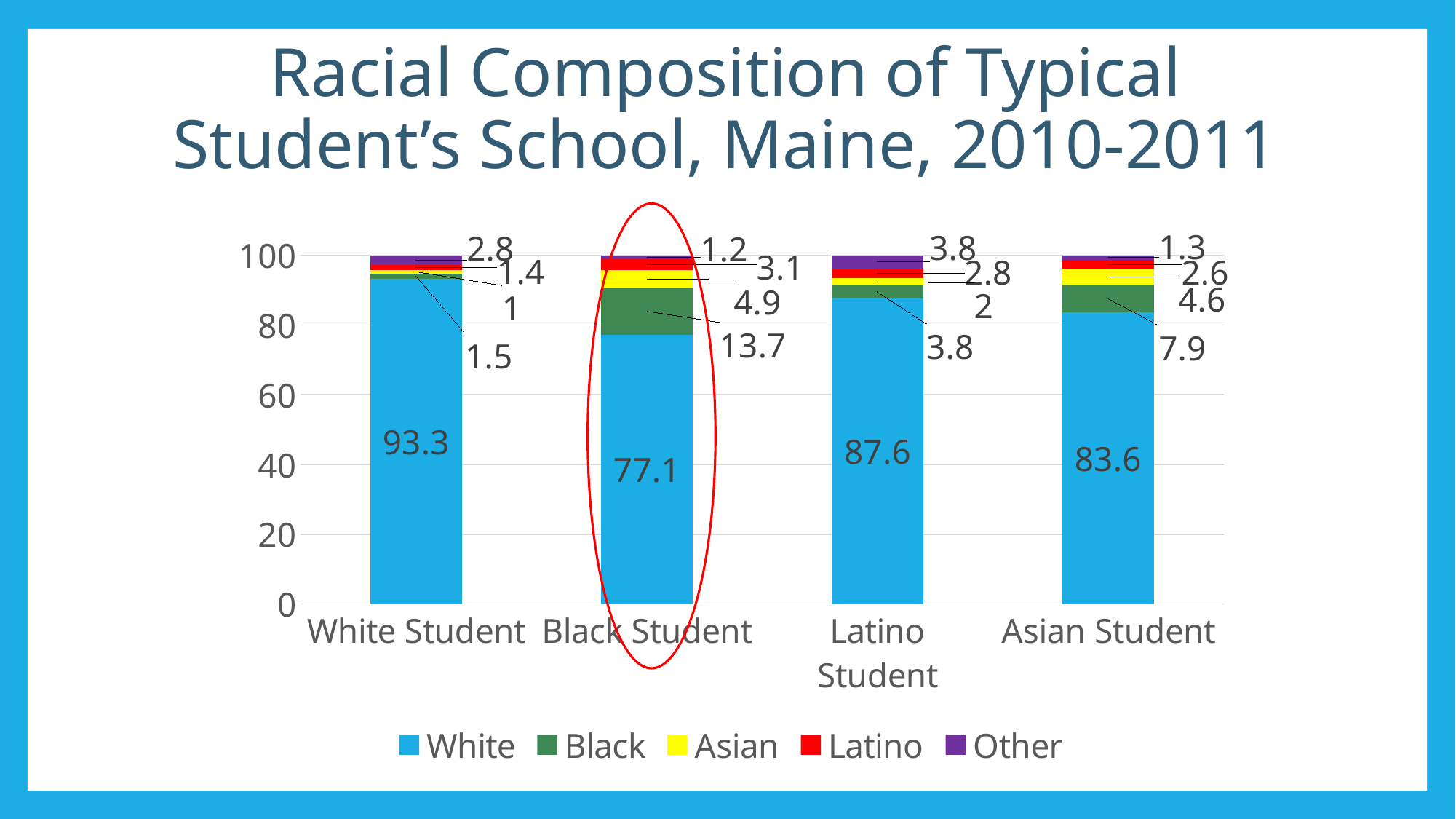
What is the difference between the White value for White Student and the White value for Black Student? 16.2 Which student category has the highest White value? White Student How many series does the legend list? 5 Which has a larger White value, Latino Student or Asian Student? Latino Student What is the White value for the Latino Student bar? 87.6 What is the Black value for the Asian Student bar? 7.9 Which student category has the lowest White value? Black Student What is the White value for the Asian Student bar? 83.6 What is the Black value for the Black Student bar? 13.7 What is the White value for the Black Student bar? 77.1 What kind of chart is shown on the slide? Stacked bar chart How many student categories are shown on the x axis? 4